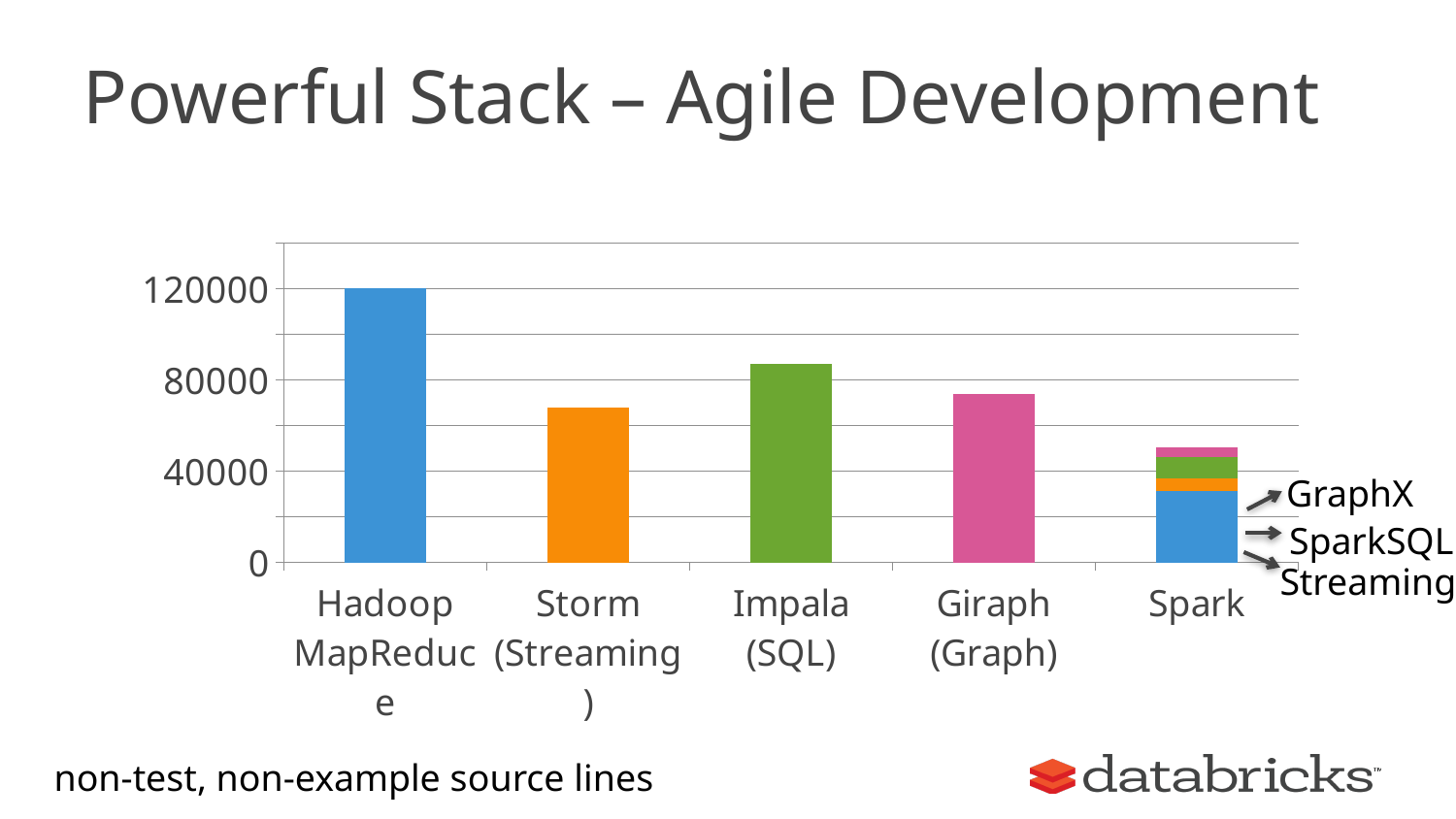
Is the value for Storm (Streaming) greater or less than 80000? less Is the value for Impala (SQL) greater or less than 80000? greater What is the title of the slide containing the chart? Powerful Stack – Agile Development Is the total value for Spark greater or less than 40000? greater Which category's bar is split into stacked segments labelled GraphX, SparkSQL and Streaming? Spark Which is larger, the value for Impala (SQL) or the value for Storm (Streaming)? Impala (SQL) How many categories are shown on the x axis of the chart? 5 What kind of chart is shown on the slide? bar chart Which category has the lowest bar in the chart? Spark What is the value for Hadoop MapReduce in the chart? 120000 Which category has the highest bar in the chart? Hadoop MapReduce